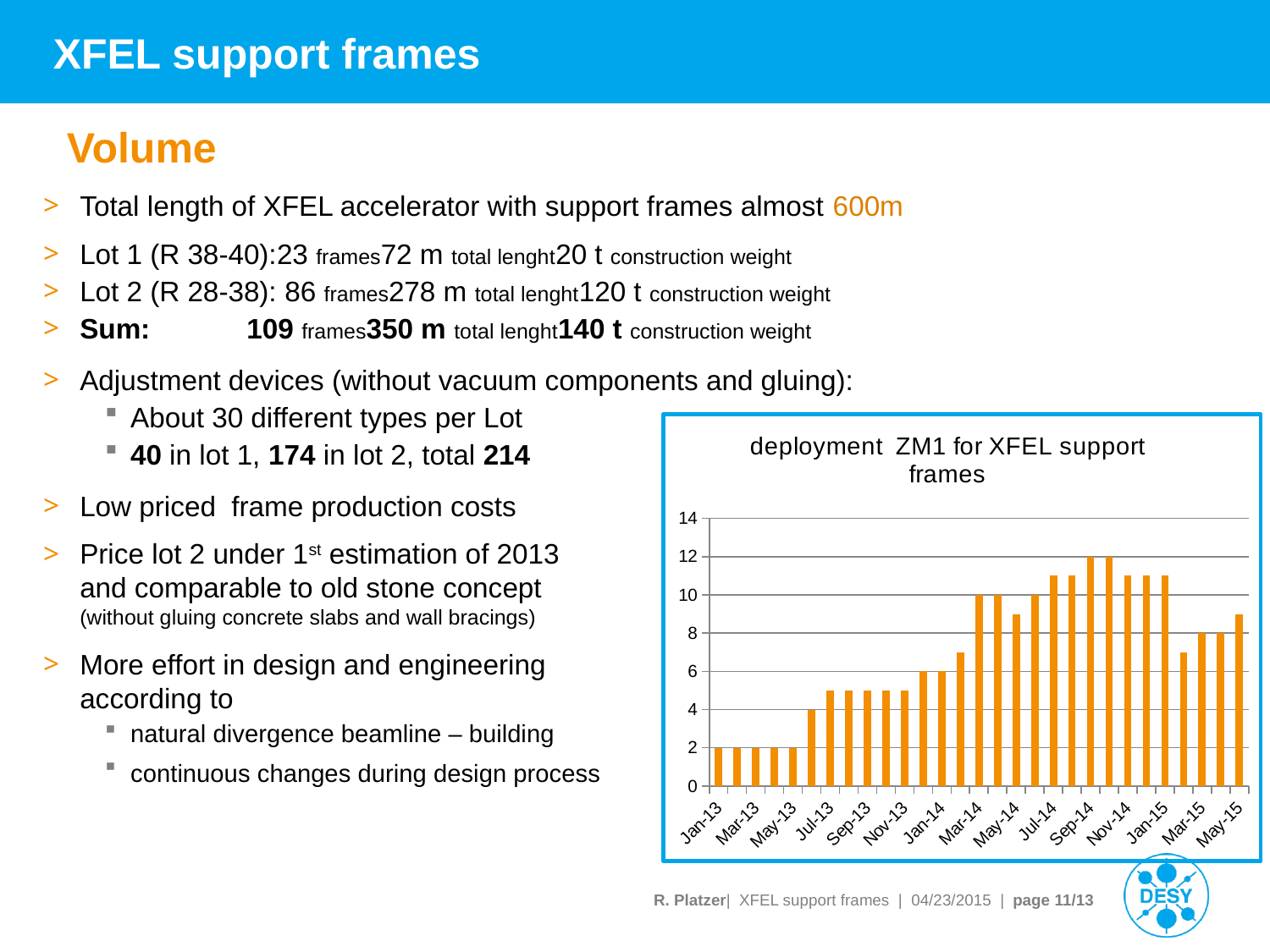
What is the value for Mar-15 in the chart? 8 What is the highest value shown on the y axis of the chart? 14 Is the value for May-15 greater or less than 10? less What type of chart is shown on the slide? bar chart What is the value for Mar-14 in the chart? 10 Do the values generally rise or fall from Jan-13 to Sep-14? rise What is the value for Jan-13 in the chart? 2 Is the value for Jan-15 greater or less than 10? greater Is the value for Jul-13 greater or less than 4? greater Which is larger, the value for Mar-13 or the value for Mar-14? Mar-14 What is the value for Sep-14 in the chart? 12 What is the title of the chart? deployment ZM1 for XFEL support frames